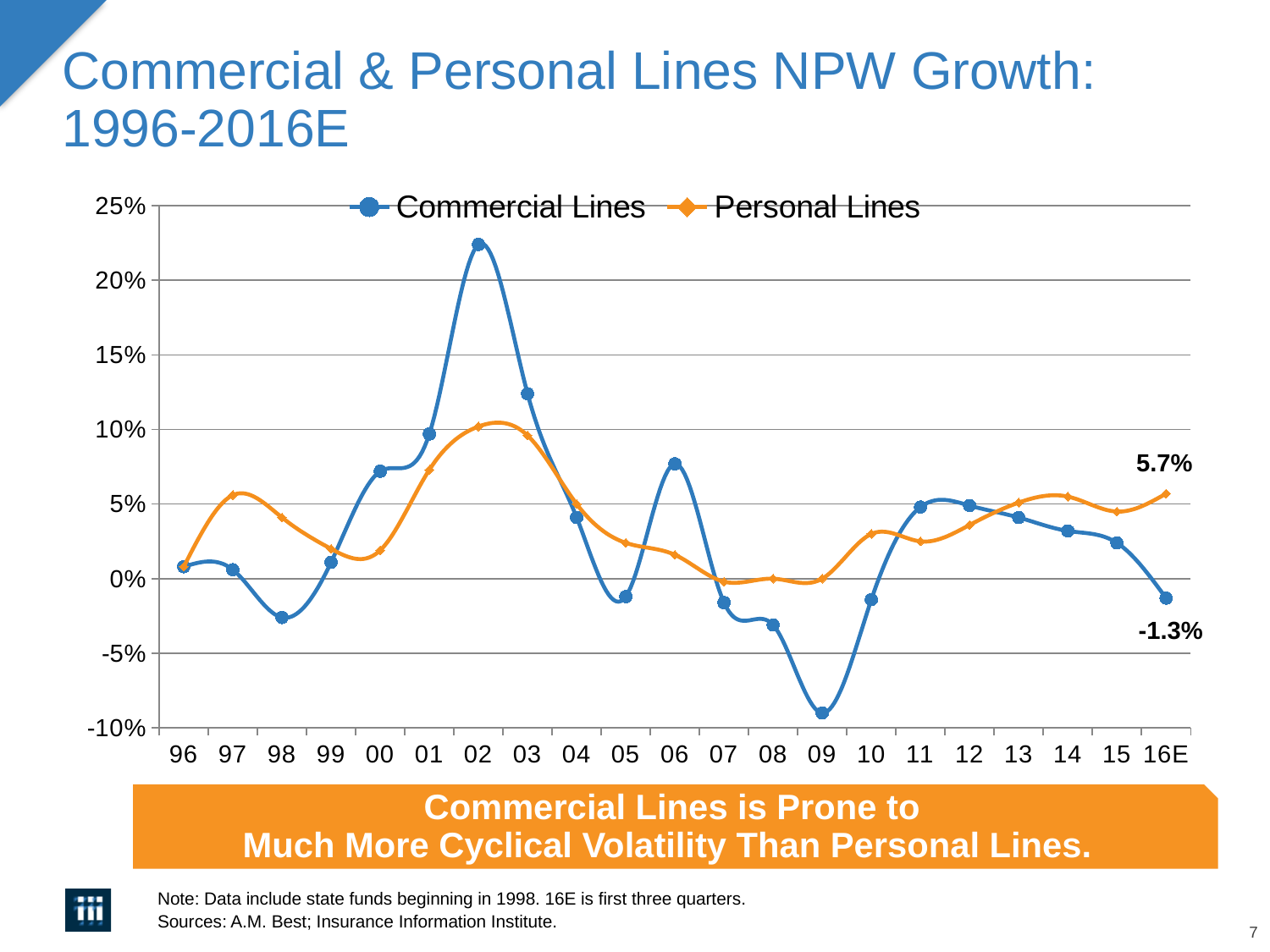
In which year does the Commercial Lines series reach its lowest value? 09 What is the difference between the Personal Lines and Commercial Lines values for 16E? 7.0 percentage points Is the Commercial Lines value for 02 greater or less than 20%? greater What is the Personal Lines NPW growth value for 16E? 5.7% In 02, which series has the higher value, Commercial Lines or Personal Lines? Commercial Lines What kind of chart is shown on the slide? line chart How many series does the legend list? 2 In which year does the Commercial Lines series reach its highest value? 02 What is the title of the chart? Commercial & Personal Lines NPW Growth: 1996-2016E What is the Commercial Lines NPW growth value for 16E? -1.3% How many years are plotted along the x axis? 21 Is the Commercial Lines value for 09 greater or less than -5%? less